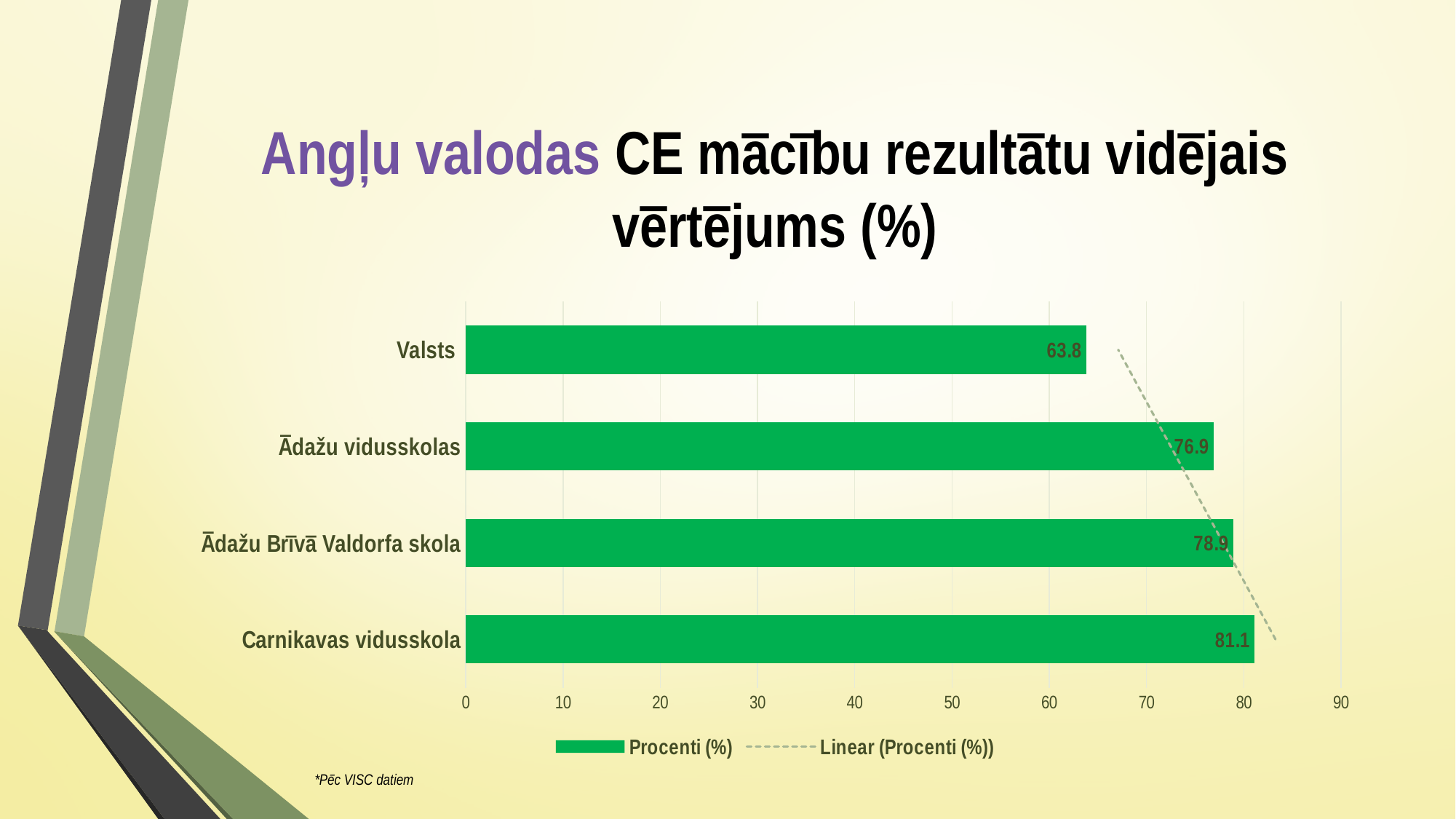
What is the value for Carnikavas vidusskola? 81.1 What is the value for Valsts? 63.8 Which category has the lowest value? Valsts Which is larger, the value for Ādažu vidusskolas or the value for Valsts? Ādažu vidusskolas What kind of chart is shown on the slide? Bar chart What is the value for Ādažu Brīvā Valdorfa skola? 78.9 How many categories are shown in the chart? 4 What is the difference between the values for Carnikavas vidusskola and Valsts? 17.3 What is the value for Ādažu vidusskolas? 76.9 How many entries does the legend list? 2 What is the difference between the values for Ādažu Brīvā Valdorfa skola and Ādažu vidusskolas? 2.0 Which category has the highest value? Carnikavas vidusskola